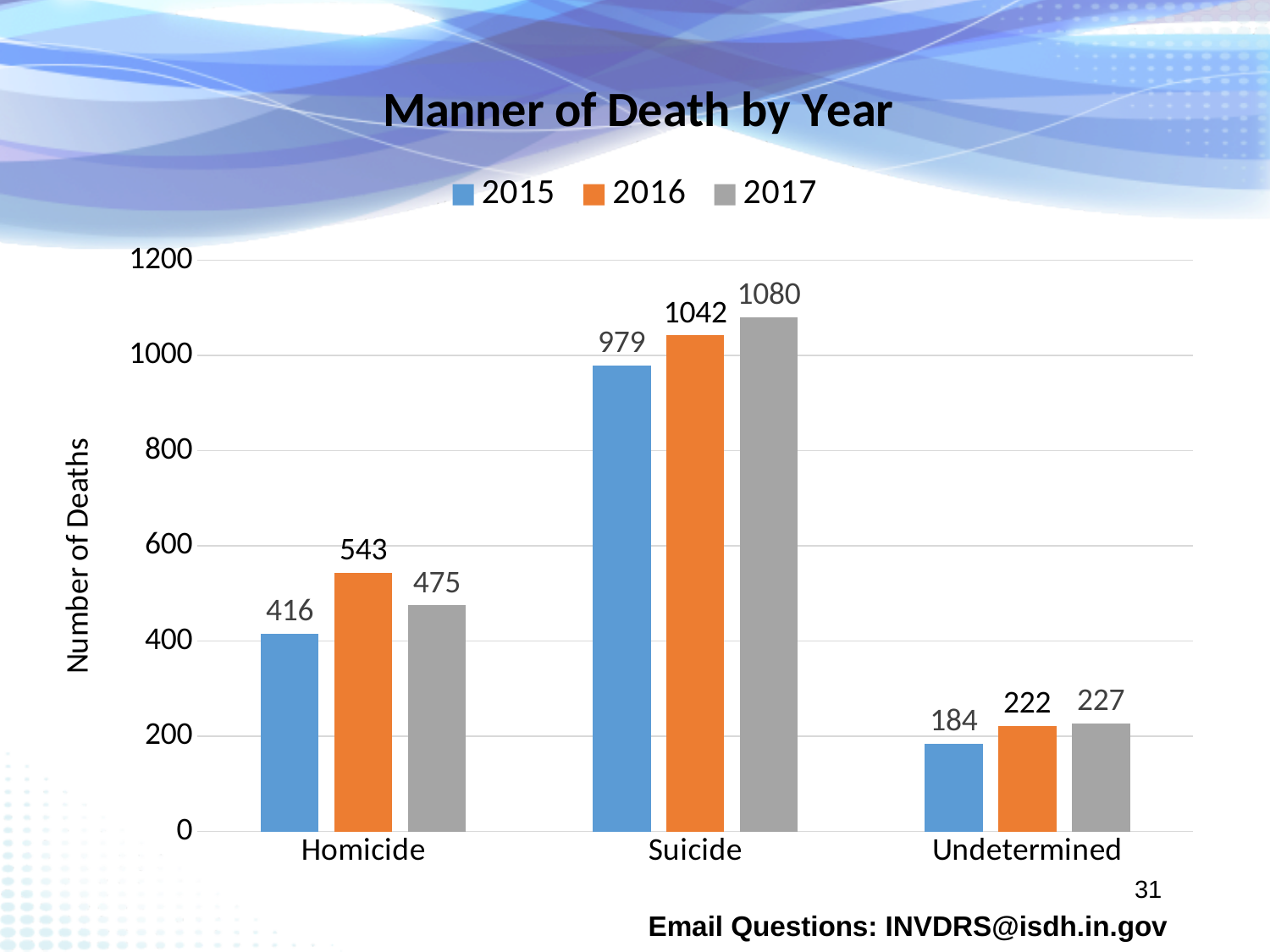
How many manner-of-death categories are shown on the x axis? 3 Do the undetermined death counts rise or fall from 2015 to 2017? Rise Which manner of death has the lowest value in 2017? Undetermined What is the title of the chart? Manner of Death by Year What is the number of homicide deaths in 2016? 543 Which manner of death has the highest value in 2016? Suicide What is the difference between suicide deaths in 2017 and 2015? 101 What is the number of suicide deaths in 2017? 1080 How many series does the legend list? 3 What is the number of undetermined deaths in 2015? 184 Which is larger: homicide deaths in 2016 or homicide deaths in 2017? 2016 What kind of chart is shown on the slide? Bar chart